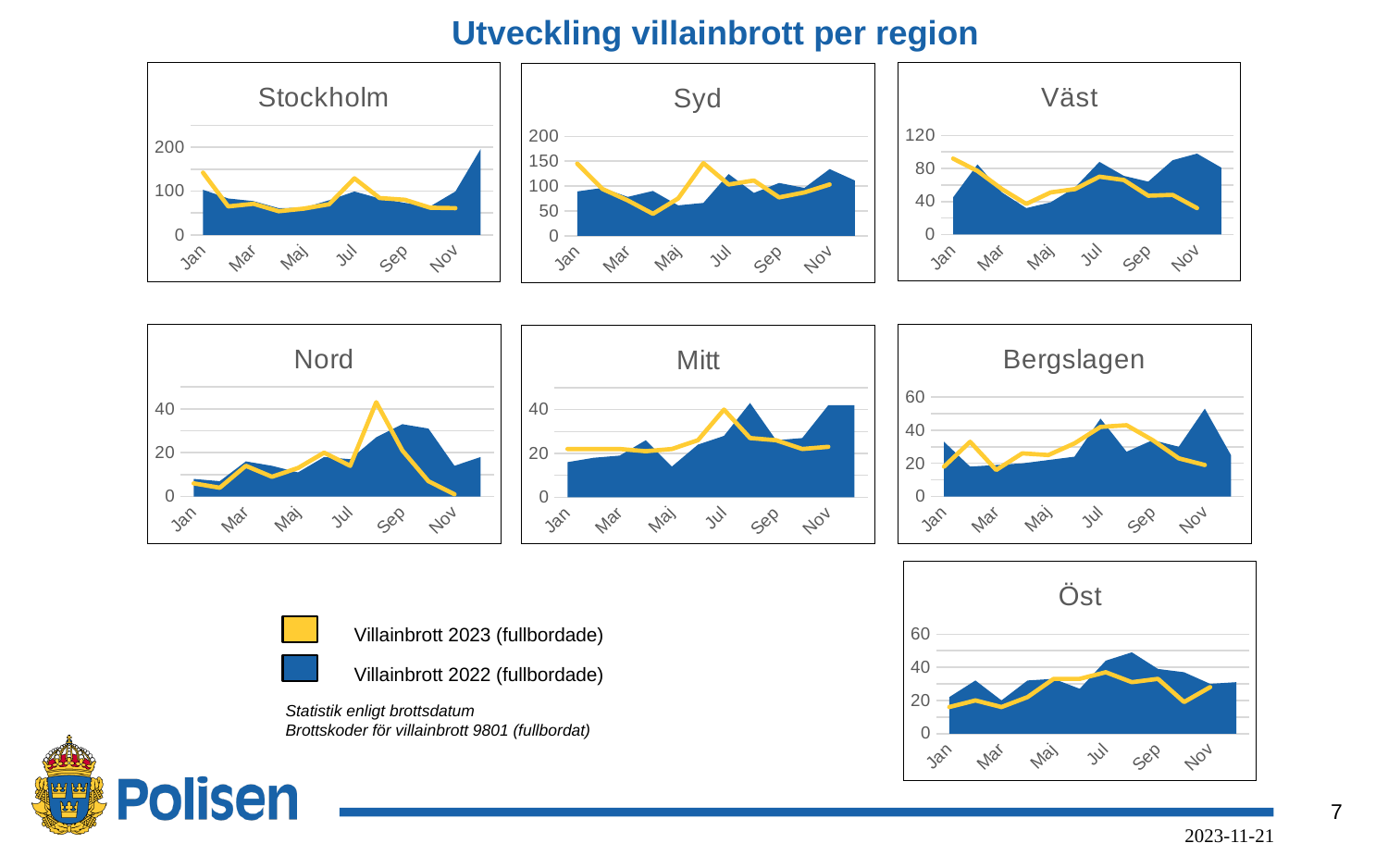
In the Stockholm chart, is the value for Villainbrott 2023 in Jan greater or less than 100? greater In the Stockholm chart, is the value for Villainbrott 2022 in Dec greater or less than 100? greater What is the title of the slide containing the charts? Utveckling villainbrott per region In the Öst chart, is the value for Villainbrott 2023 in Jan greater or less than 20? less How many series does the legend list for the charts? 2 Which series is shown in yellow according to the legend? Villainbrott 2023 (fullbordade)